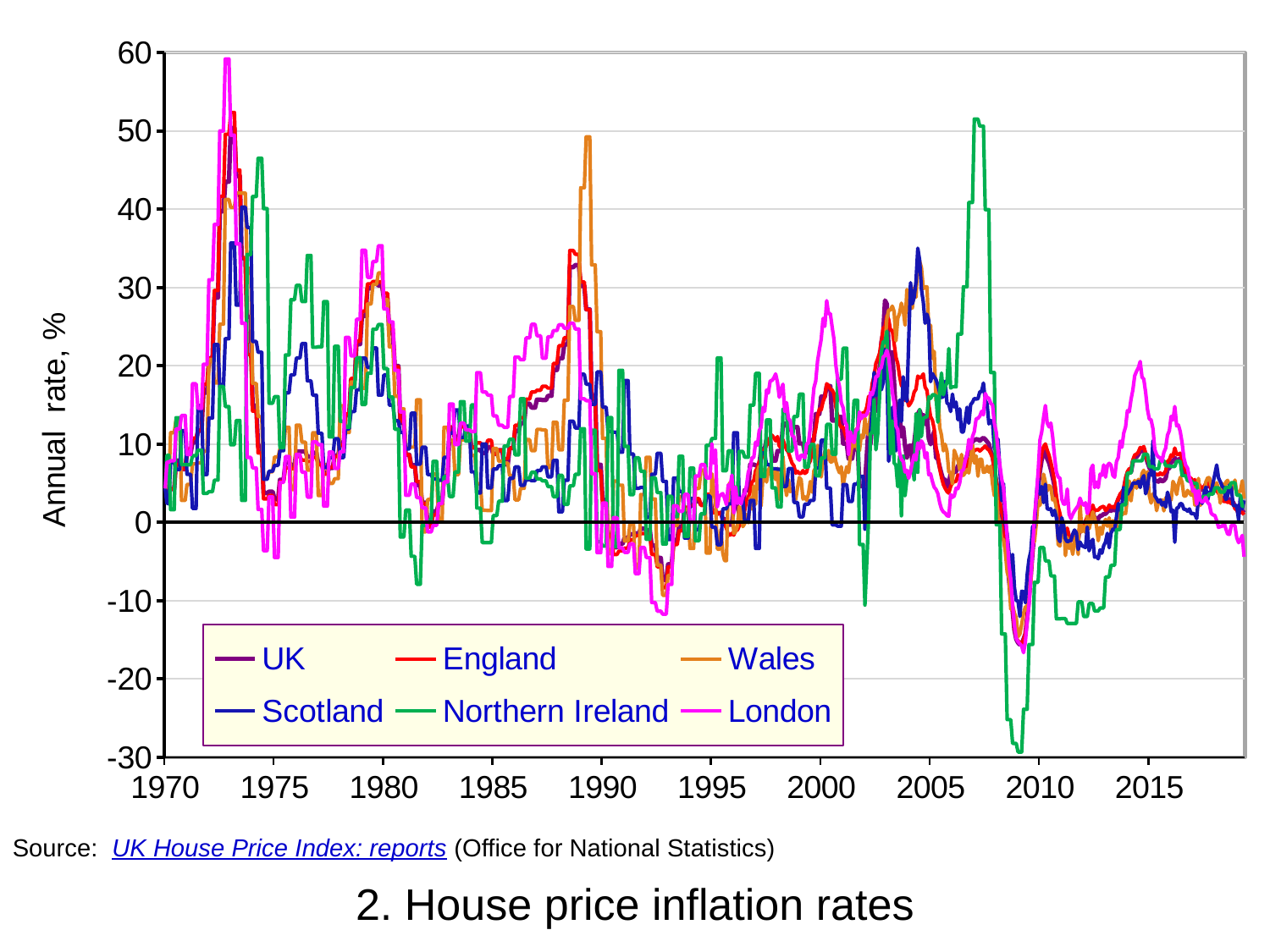
Is the peak value for Wales around 1989 greater or less than 40? greater Around 1973, which series peaks higher, London or Scotland? London Which series reaches the highest value anywhere on the chart? London Between 2007 and 2009, do the series generally rise or fall? fall What kind of chart is shown on the slide? line chart What is the label on the y axis? Annual rate, % Which series reaches the lowest value anywhere on the chart? Northern Ireland How many series does the legend list? 6 Is the peak value for London around 1973 greater or less than 50? greater Is the peak value for Northern Ireland around 2007 greater or less than 40? greater What is the title of the chart? 2. House price inflation rates